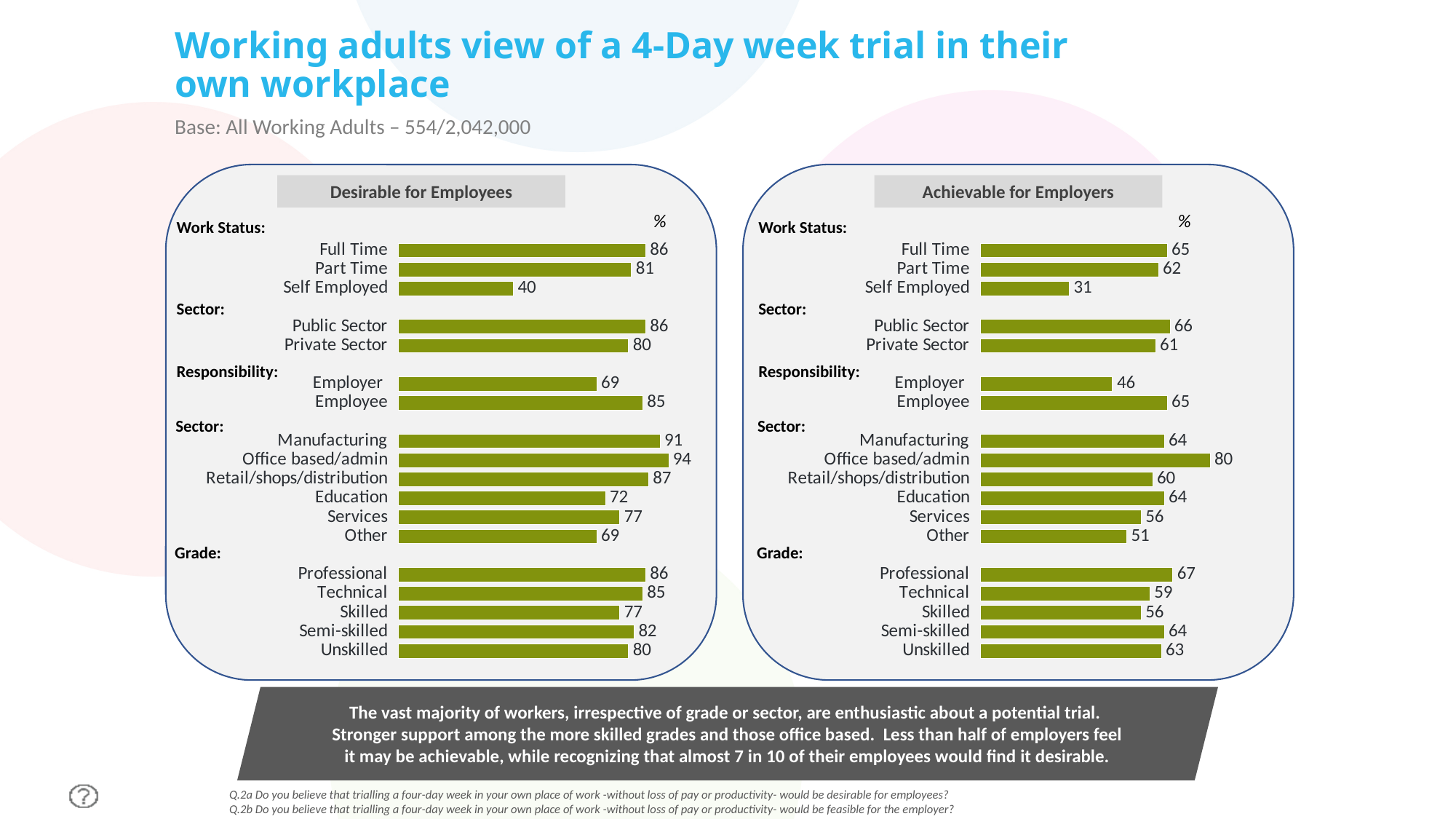
In the 'Desirable for Employees' chart, how many categories are listed under Grade? 5 In the 'Desirable for Employees' chart, what is the difference between Employee and Employer? 16 In the 'Achievable for Employers' chart, what is the value for Office based/admin? 80 In the 'Desirable for Employees' chart, which category has the highest value? Office based/admin In the 'Achievable for Employers' chart, which category has the lowest value? Self Employed In the 'Achievable for Employers' chart, which is larger: Professional or Technical? Professional What is the base stated on the slide? All Working Adults – 554/2,042,000 In the 'Achievable for Employers' chart, what is the value for Employer under Responsibility? 46 In the 'Desirable for Employees' chart, what is the value for Self Employed? 40 In the 'Desirable for Employees' chart, which is larger: Education or Services? Services What kind of chart is used in the 'Achievable for Employers' panel? Bar chart In the 'Achievable for Employers' chart, what is the difference between Public Sector and Private Sector? 5